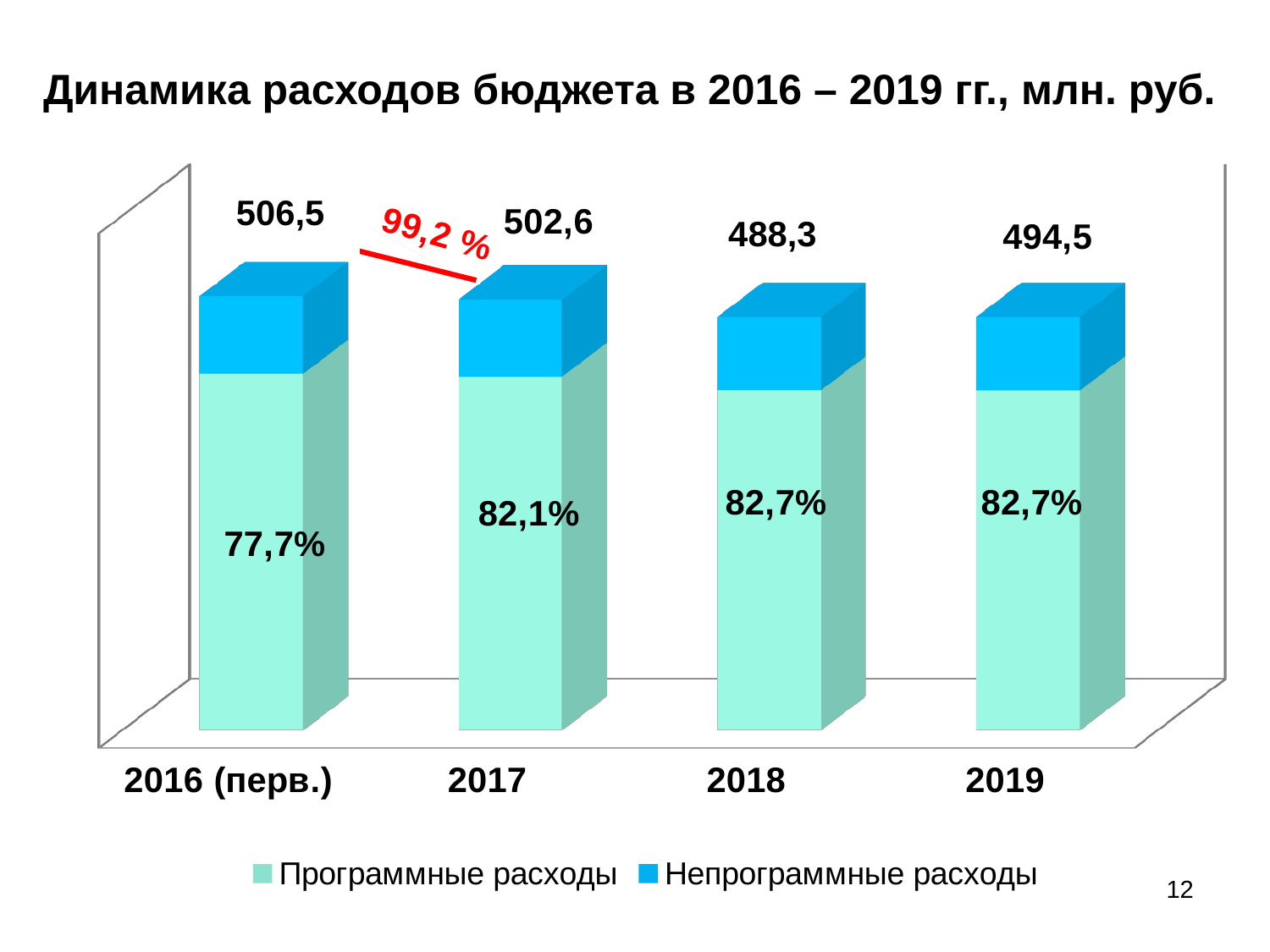
What is the difference between the total expenditure for 2016 (перв.) and 2018? 18,2 How many years are shown on the x axis? 4 Do the total expenditure values rise or fall from 2016 (перв.) to 2018? Fall What is the total budget expenditure shown for 2017? 502,6 Which year has the lowest total budget expenditure? 2018 Which is larger, the total expenditure for 2017 or for 2019? 2017 Which year has the highest total budget expenditure? 2016 (перв.) What percentage label is shown on the Программные расходы segment for 2019? 82,7% What is the total budget expenditure shown for 2018? 488,3 What percentage label is shown on the Программные расходы segment for 2016 (перв.)? 77,7% What kind of chart is shown on the slide? Stacked bar chart How many series does the legend list? 2